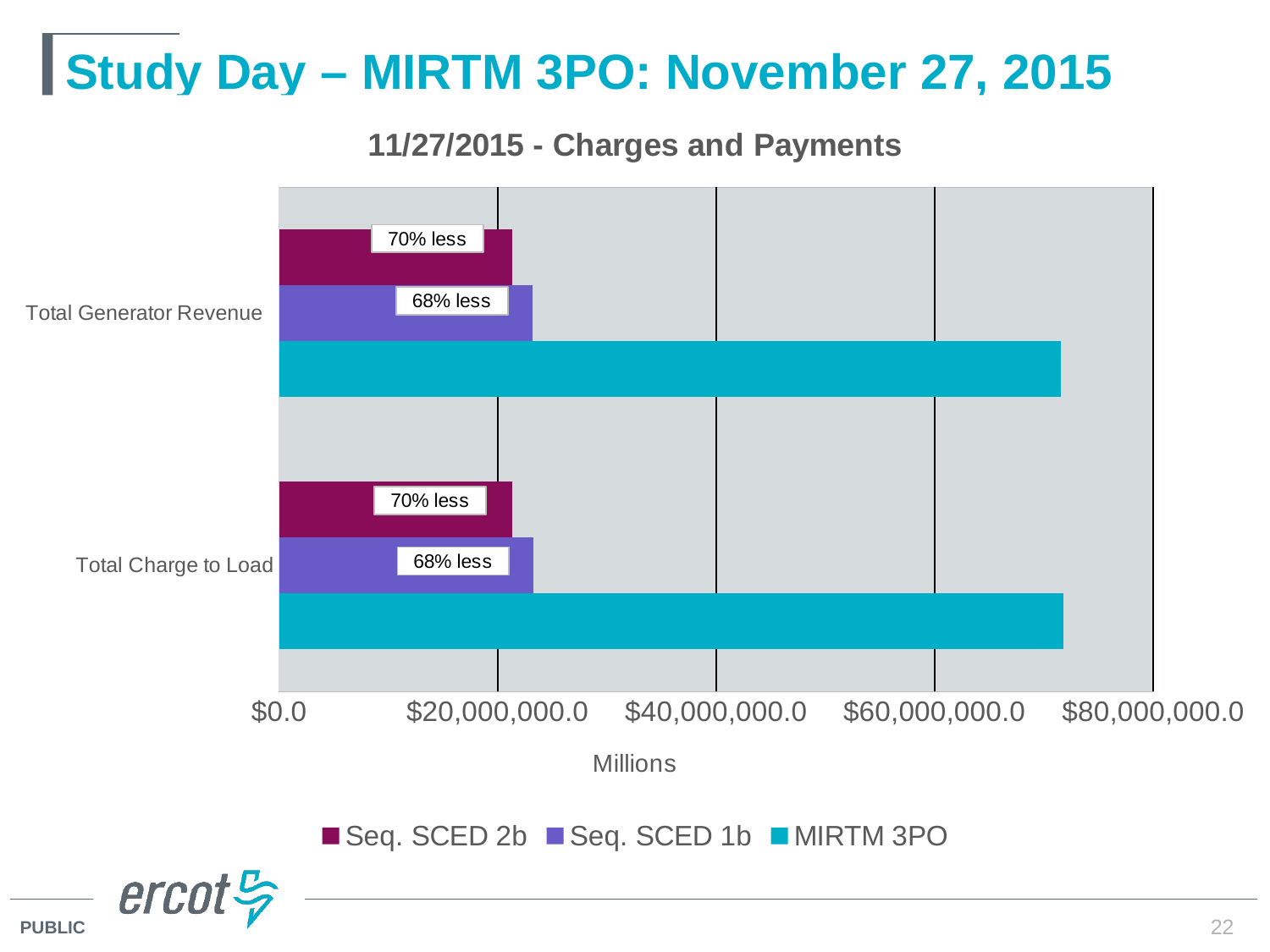
What is the title of the chart? 11/27/2015 - Charges and Payments Which series has the highest value for Total Generator Revenue? MIRTM 3PO Which series has the lowest value for Total Charge to Load? Seq. SCED 2b What kind of chart is shown on the slide? bar chart Is the Seq. SCED 1b value for Total Charge to Load greater or less than $40,000,000.0? less What label is shown on the Seq. SCED 2b bar for Total Generator Revenue? 70% less What is the label shown below the horizontal axis? Millions How many series does the legend list? 3 For Total Charge to Load, which is larger: MIRTM 3PO or Seq. SCED 1b? MIRTM 3PO What label is shown on the Seq. SCED 1b bar for Total Charge to Load? 68% less How many categories are shown on the vertical axis? 2 Is the MIRTM 3PO value for Total Generator Revenue greater or less than $60,000,000.0? greater